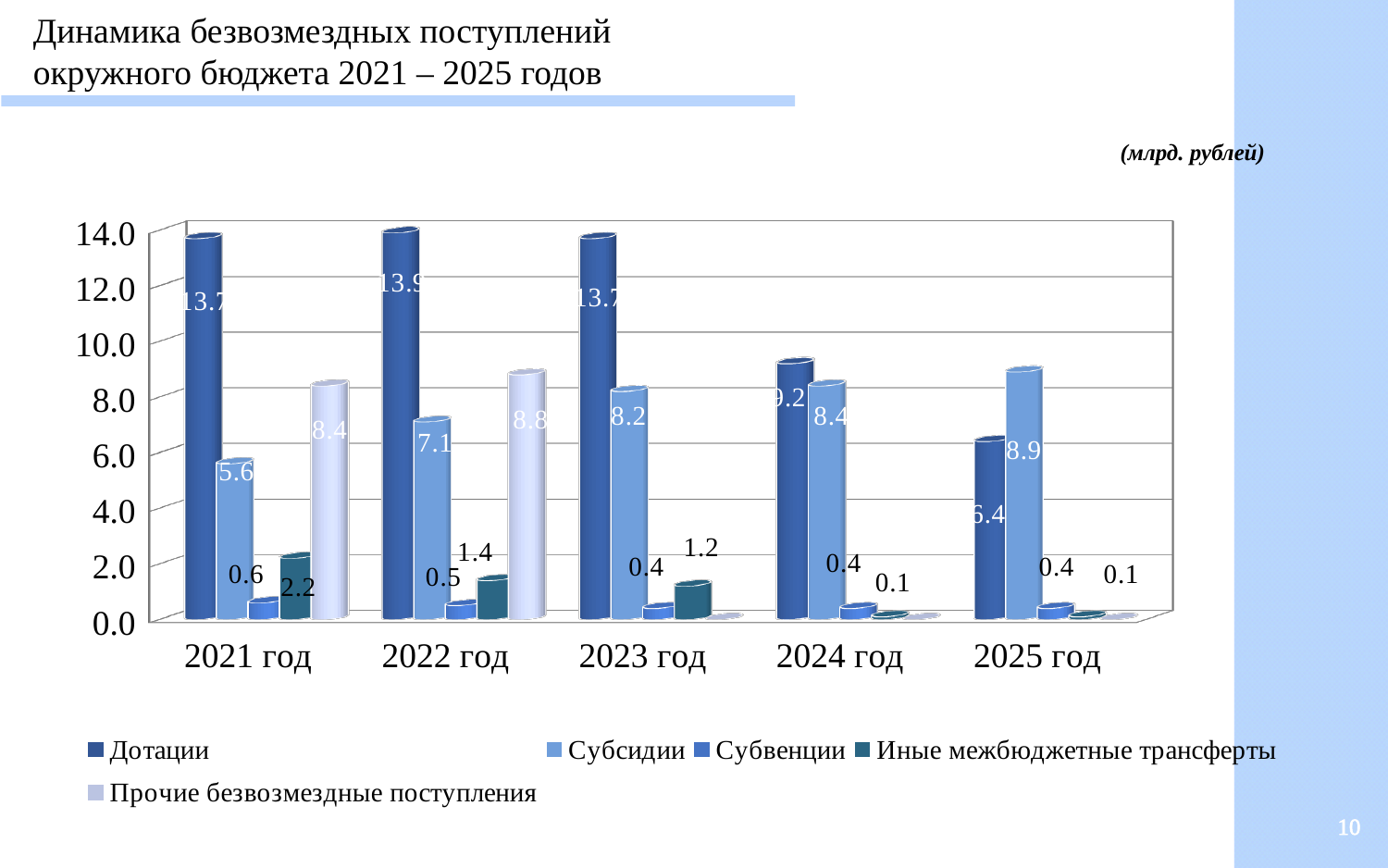
In 2025 год, which is larger: Дотации or Субсидии? Субсидии What is the value of Прочие безвозмездные поступления for 2021 год? 8.4 How many series does the legend list? 5 In which year is the value of Субсидии the highest? 2025 год What is the value of Иные межбюджетные трансферты for 2021 год? 2.2 What kind of chart is shown on the slide? bar chart How many years are shown on the x axis? 5 What is the value of Субсидии for 2025 год? 8.9 Do the values of Субсидии rise or fall from 2021 год to 2025 год? rise What is the value of Дотации for 2022 год? 13.9 In which year is the value of Дотации the lowest? 2025 год What is the difference between Дотации and Субсидии in 2024 год? 0.8